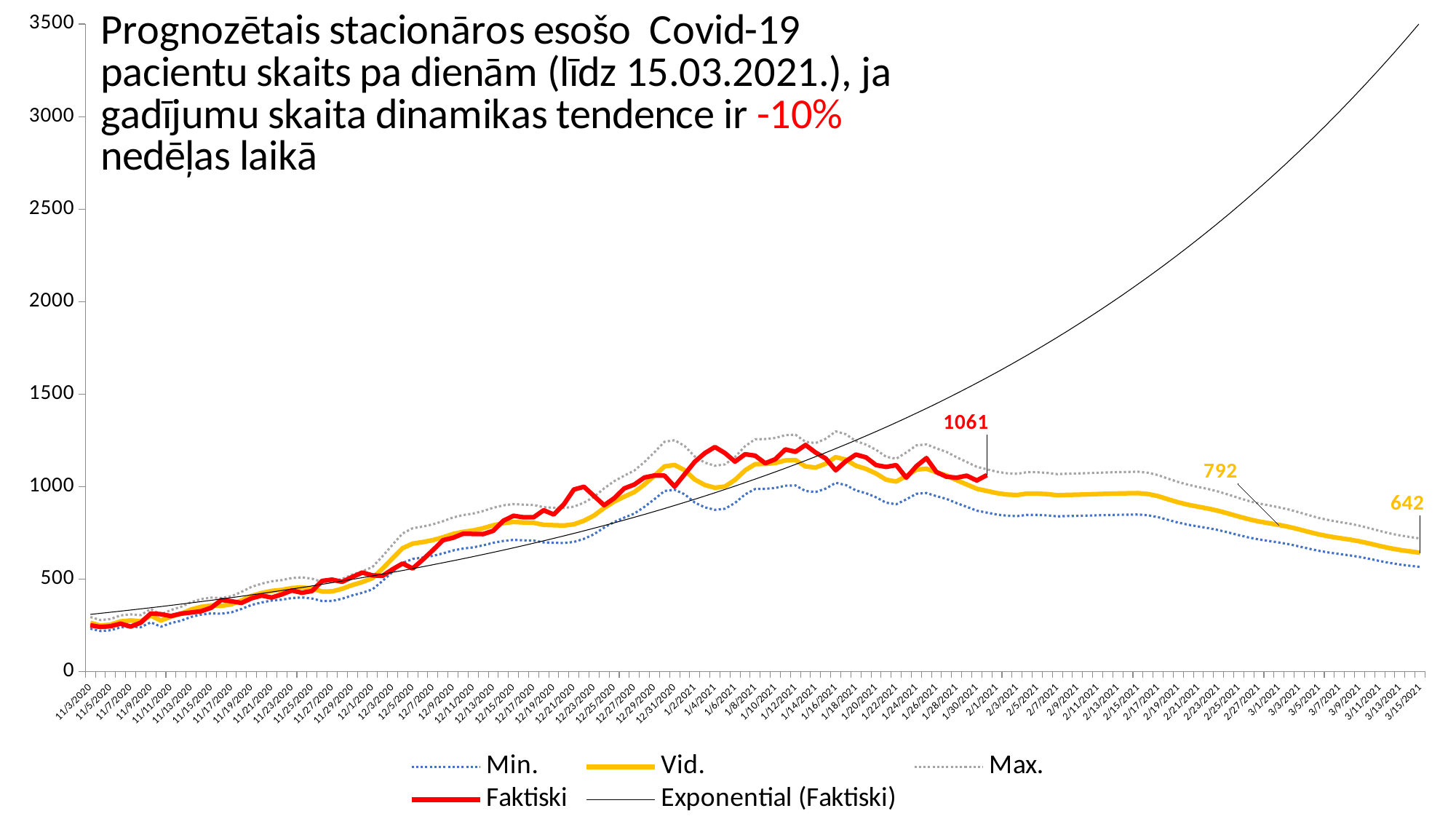
Does the Vid. series rise or fall between 2/1/2021 and 3/15/2021? fall What percentage is highlighted in red in the chart title? -10% Is the value of the Min. series at 3/15/2021 greater or less than 1000? less At 3/15/2021, which series has the larger value: Exponential (Faktiski) or Vid.? Exponential (Faktiski) What is the labelled value of the Vid. series at 3/15/2021? 642 What is the labelled value of the Vid. series shown near the end of February 2021? 792 What is the last labelled value of the Faktiski series? 1061 What is the difference between the two labelled Vid. values, 792 and 642? 150 What kind of chart is shown on the slide? line chart What is the difference between the labelled Faktiski value 1061 and the Vid. value 642 at 3/15/2021? 419 How many series does the legend list? 5 Is the value of the Exponential (Faktiski) series at 3/15/2021 greater or less than 3000? greater